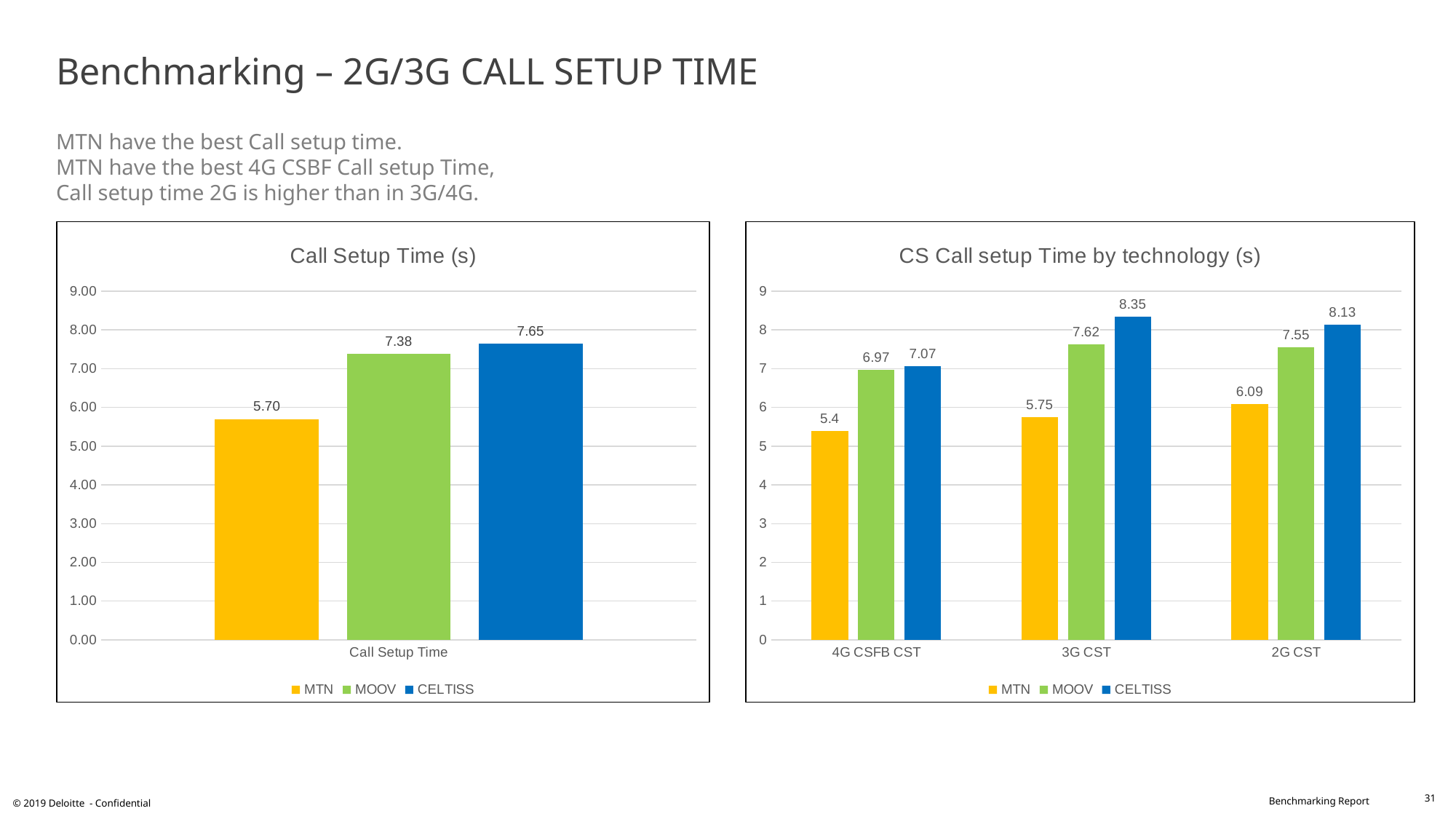
In the 'Call Setup Time (s)' chart, how many series does the legend list? 3 In the 'Call Setup Time (s)' chart, which operator has the highest call setup time? CELTISS What type of chart is the 'CS Call setup Time by technology (s)' chart? bar chart In the 'CS Call setup Time by technology (s)' chart, what is the value for CELTISS in the 3G CST category? 8.35 In the 'Call Setup Time (s)' chart, what is the value for MTN? 5.70 In the 'CS Call setup Time by technology (s)' chart, what is the value for MOOV in the 2G CST category? 7.55 In the 'Call Setup Time (s)' chart, what is the difference between the CELTISS and MTN values? 1.95 In the 'CS Call setup Time by technology (s)' chart, how many categories are shown on the x axis? 3 In the 'CS Call setup Time by technology (s)' chart, is the MTN value for 2G CST larger or smaller than the MTN value for 3G CST? larger In the 'CS Call setup Time by technology (s)' chart, what is the difference between the CELTISS and MOOV values for 4G CSFB CST? 0.10 In the 'Call Setup Time (s)' chart, which colour represents MOOV? green In the 'CS Call setup Time by technology (s)' chart, which category has the lowest MTN value? 4G CSFB CST